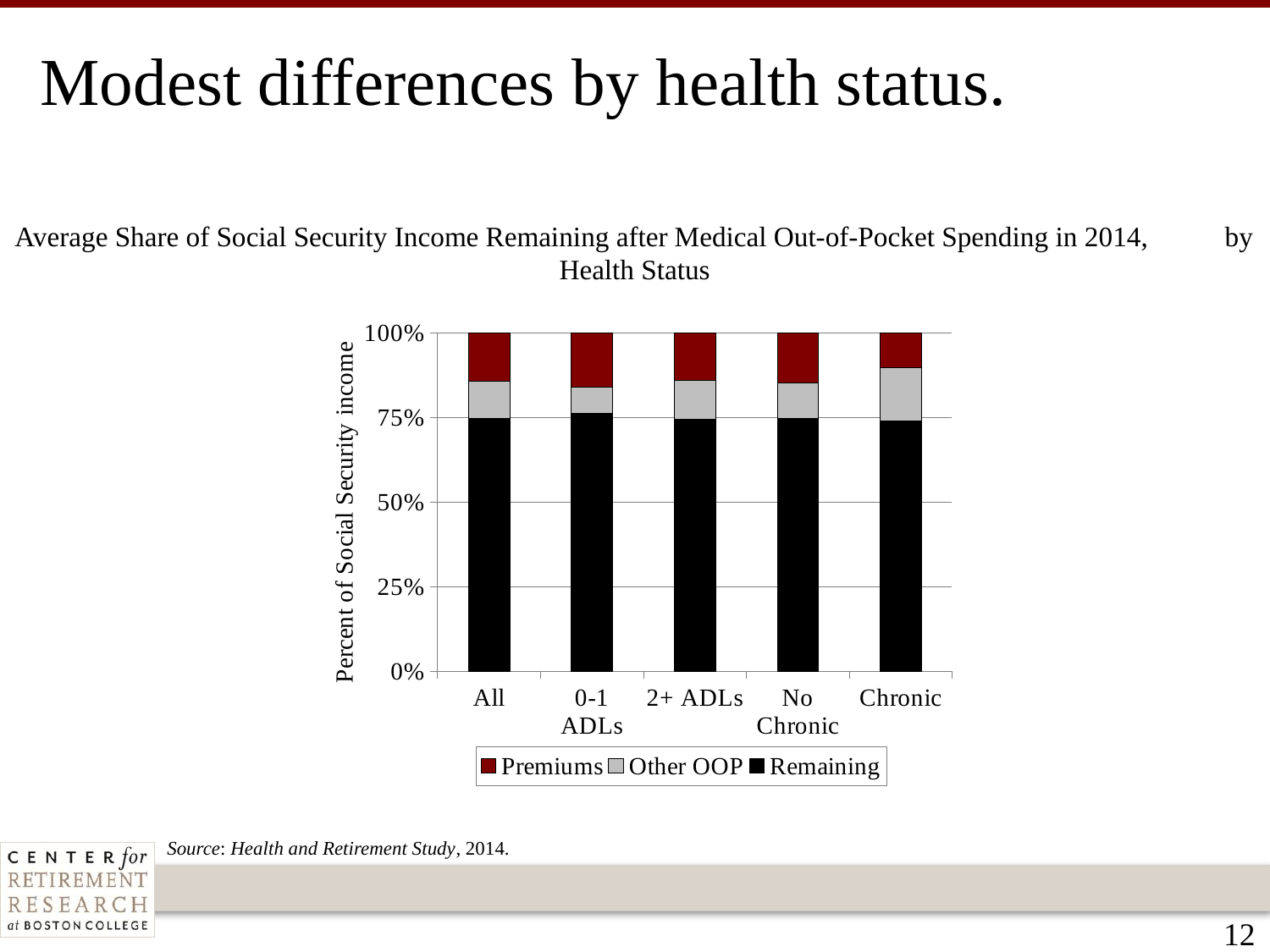
How many series does the chart's legend list? 3 What kind of chart is shown on the slide? Stacked bar chart Is the 'Premiums' segment larger for '0-1 ADLs' or for 'Chronic'? 0-1 ADLs Is the 'Remaining' share for the 'All' category greater or less than 50%? greater What are the three series listed in the chart's legend? Premiums, Other OOP, Remaining How many health status categories are shown on the x axis of the chart? 5 Is the 'Other OOP' segment larger for 'Chronic' or for 'No Chronic'? Chronic Which category has the smallest 'Premiums' segment? Chronic What is the label on the chart's vertical axis? Percent of Social Security income Is the 'Premiums' share for the 'Chronic' category greater or less than 25%? less What is the total height of the stacked bar for the 'All' category? 100% Which category has the largest 'Other OOP' segment? Chronic